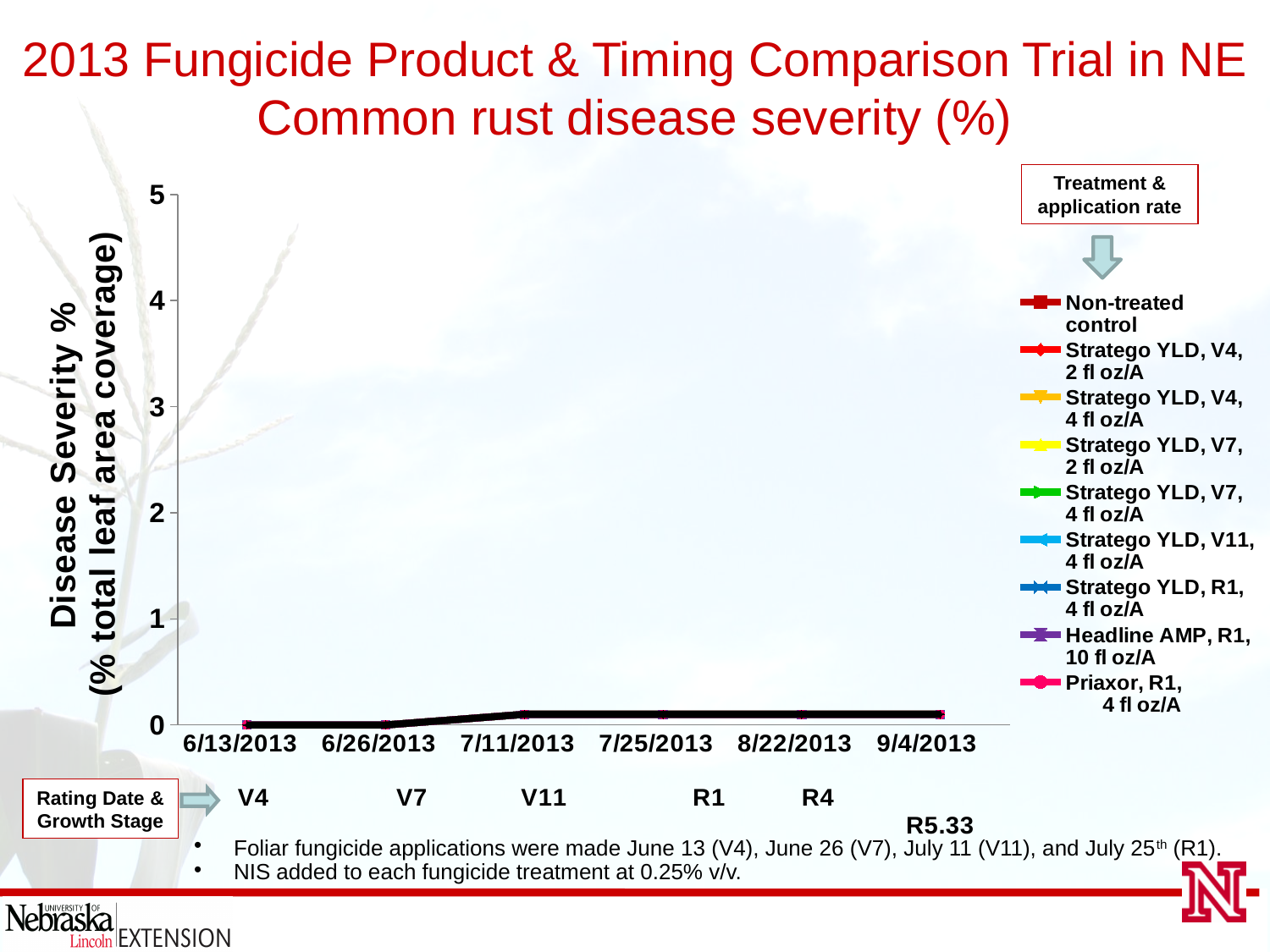
What is the first rating date shown on the x axis? 6/13/2013 How many rating dates are shown along the x axis? 6 Is the value for Priaxor, R1, 4 fl oz/A on 7/25/2013 greater or less than 1? less What is the highest value shown on the y axis? 5 Is the value for Headline AMP, R1, 10 fl oz/A on 8/22/2013 greater or less than 2? less How many series does the legend list? 9 What kind of chart is shown on the slide? line chart Is the value for the Non-treated control on 9/4/2013 greater or less than 1? less